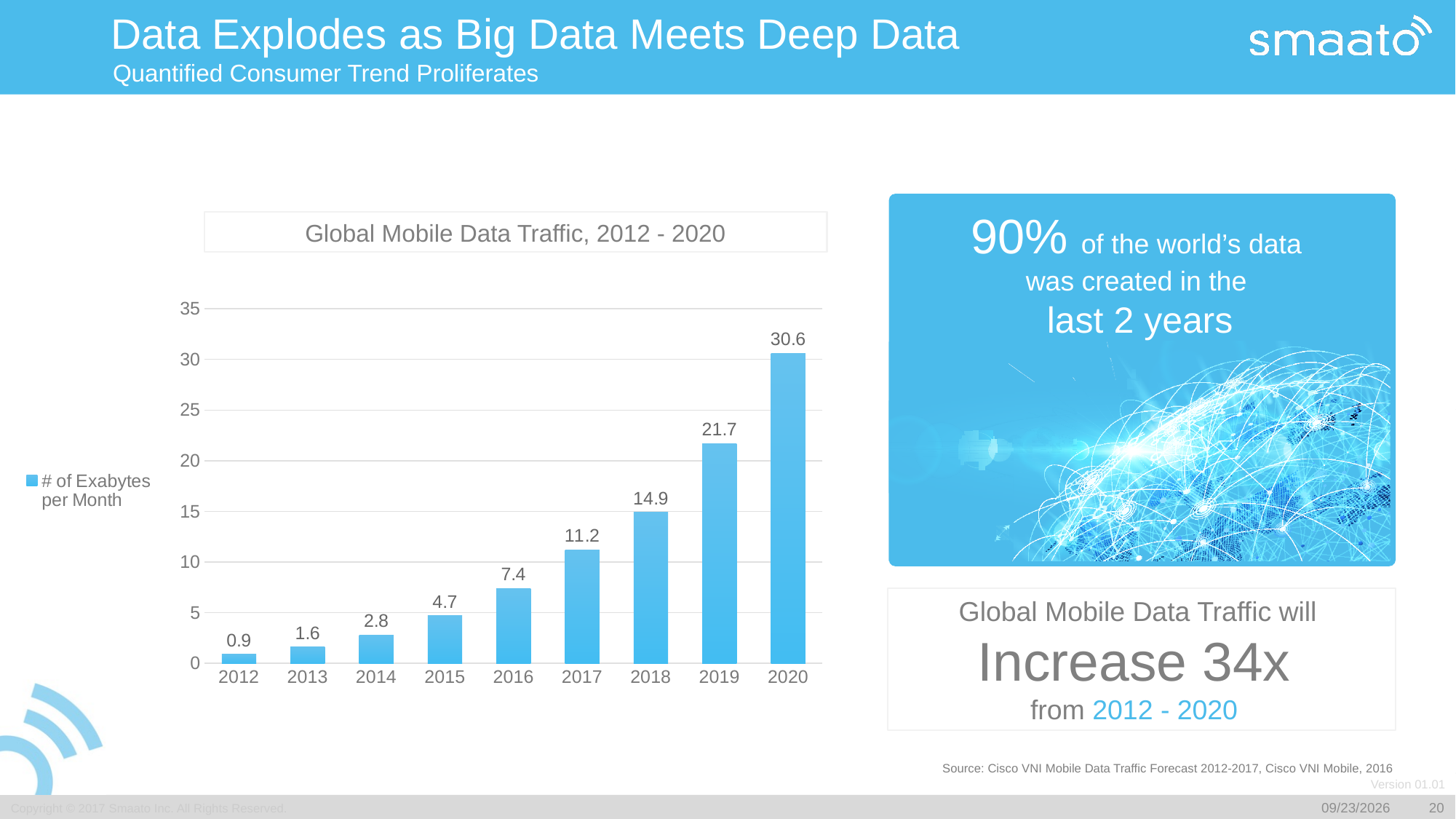
What is the value for 2016 in the Global Mobile Data Traffic chart? 7.4 What is the number of exabytes per month shown for 2019? 21.7 Is the value for 2018 greater or less than 10? greater Do the values rise or fall from 2012 to 2020? Rise Which is larger, the value for 2015 or the value for 2014? 2015 How many series does the chart legend list? 1 Which year has the lowest value in the chart? 2012 How many years are shown on the x axis of the chart? 9 What is the difference between the values for 2018 and 2017? 3.7 What is the difference between the values for 2020 and 2019? 8.9 What kind of chart is used to show Global Mobile Data Traffic? Bar chart Which year has the highest value in the chart? 2020